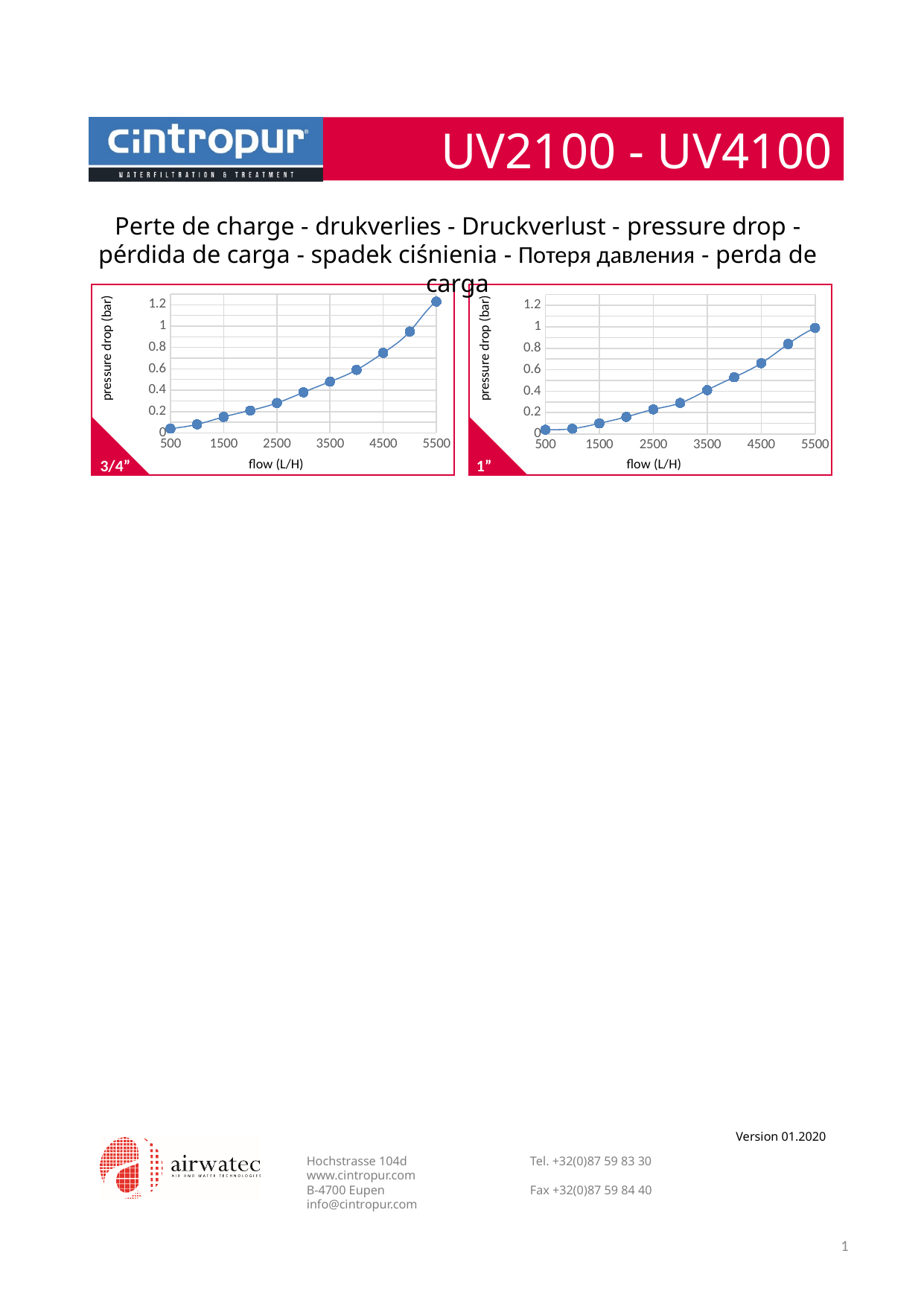
On the 3/4" chart, at which flow value is the pressure drop lowest? 500 On the 1" chart, is the pressure drop at 3500 L/H greater or less than 0.6 bar? less On the 3/4" chart, is the pressure drop at 5500 L/H greater or less than 1 bar? greater What is the label on the y axis of the 1" chart? pressure drop (bar) On the 1" chart, at which flow value is the pressure drop highest? 5500 On the 1" chart, is the pressure drop at 4500 L/H greater or less than 0.6 bar? greater What kind of chart is the 3/4" chart on the left? line chart What is the label on the x axis of the 3/4" chart? flow (L/H) At a flow of 5500 L/H, which chart shows the larger pressure drop, the 3/4" chart or the 1" chart? 3/4" chart On the 3/4" chart, does the pressure drop rise or fall as flow increases? rise How many data points are plotted on the 1" chart on the right? 11